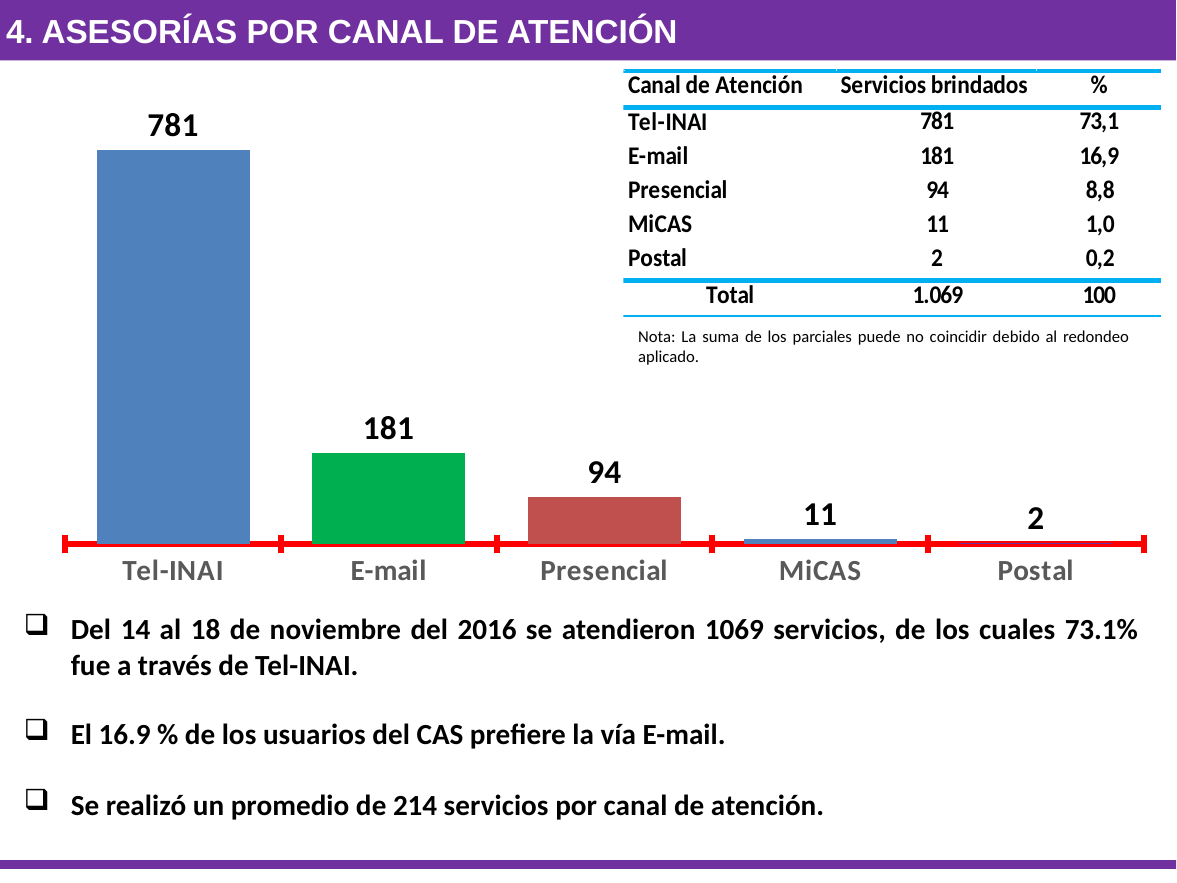
What is the value for Presencial in the bar chart? 94 What is the value for E-mail in the bar chart? 181 What is the difference between the values for Presencial and MiCAS? 83 What is the value for Tel-INAI in the bar chart? 781 Which category has the lowest value in the bar chart? Postal Which category has the highest value in the bar chart? Tel-INAI What kind of chart is shown on the slide? Bar chart How many categories are shown in the bar chart? 5 What is the difference between the values for Tel-INAI and E-mail? 600 What is the value for Postal in the bar chart? 2 Do the values rise or fall from left to right across the categories? Fall Which is larger, the value for E-mail or the value for Presencial? E-mail